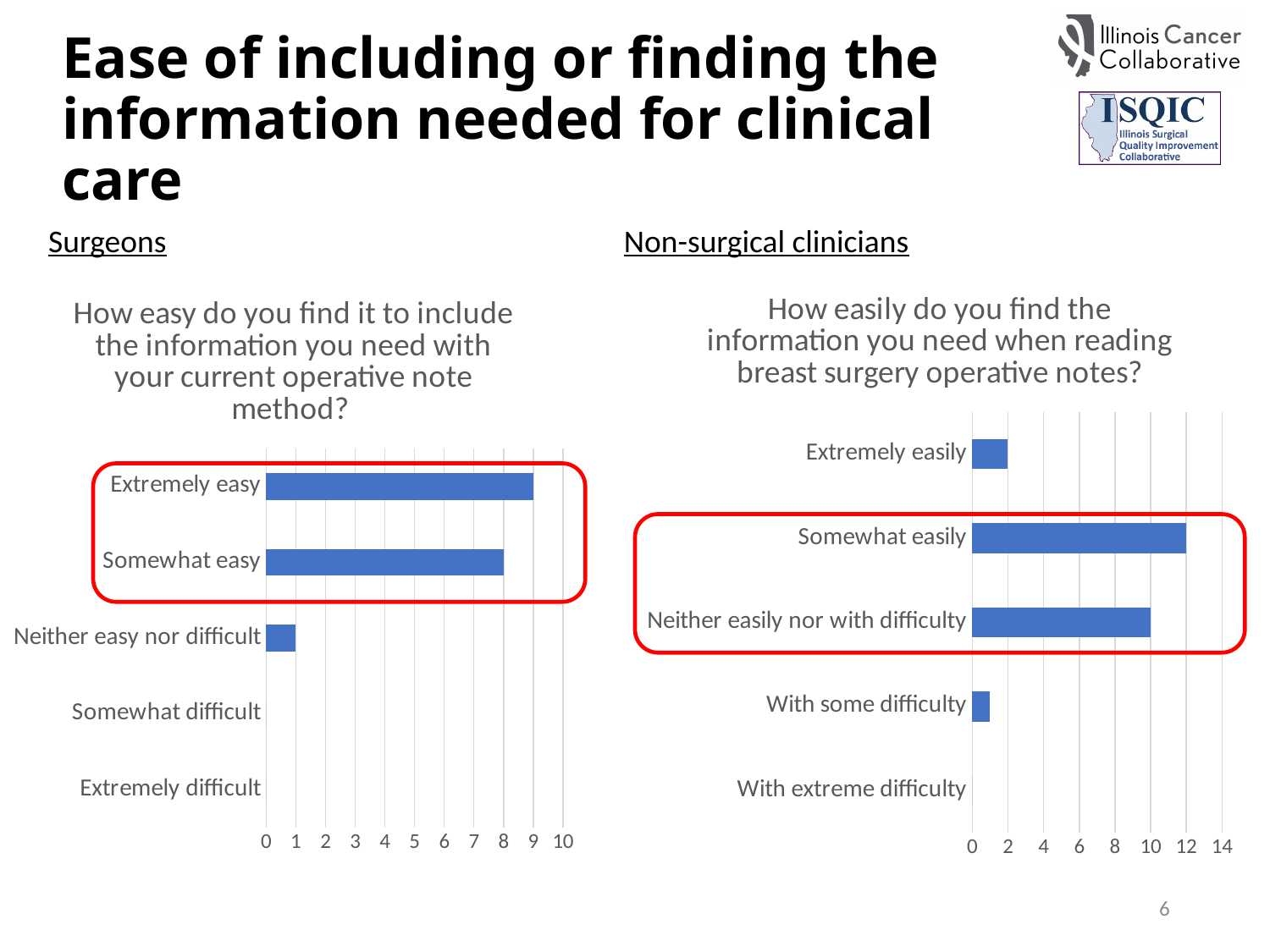
In the Surgeons chart, how many categories are shown on the vertical axis? 5 In the Non-surgical clinicians chart, is the value for "With some difficulty" greater or less than 2? less What kind of chart is the Surgeons chart? Bar chart In the Surgeons chart, what is the value for "Somewhat easy"? 8 What is the highest value shown on the horizontal axis of the Non-surgical clinicians chart? 14 In the Non-surgical clinicians chart, what is the value for "Somewhat easily"? 12 In the Non-surgical clinicians chart, which is larger, the value for "Extremely easily" or the value for "Neither easily nor with difficulty"? Neither easily nor with difficulty In the Surgeons chart, what is the value for "Extremely easy"? 9 In the Non-surgical clinicians chart, which category has the highest value? Somewhat easily In the Surgeons chart, what is the difference between the values for "Extremely easy" and "Neither easy nor difficult"? 8 In the Non-surgical clinicians chart, what is the value for "Neither easily nor with difficulty"? 10 In the Surgeons chart, which category has the highest value? Extremely easy